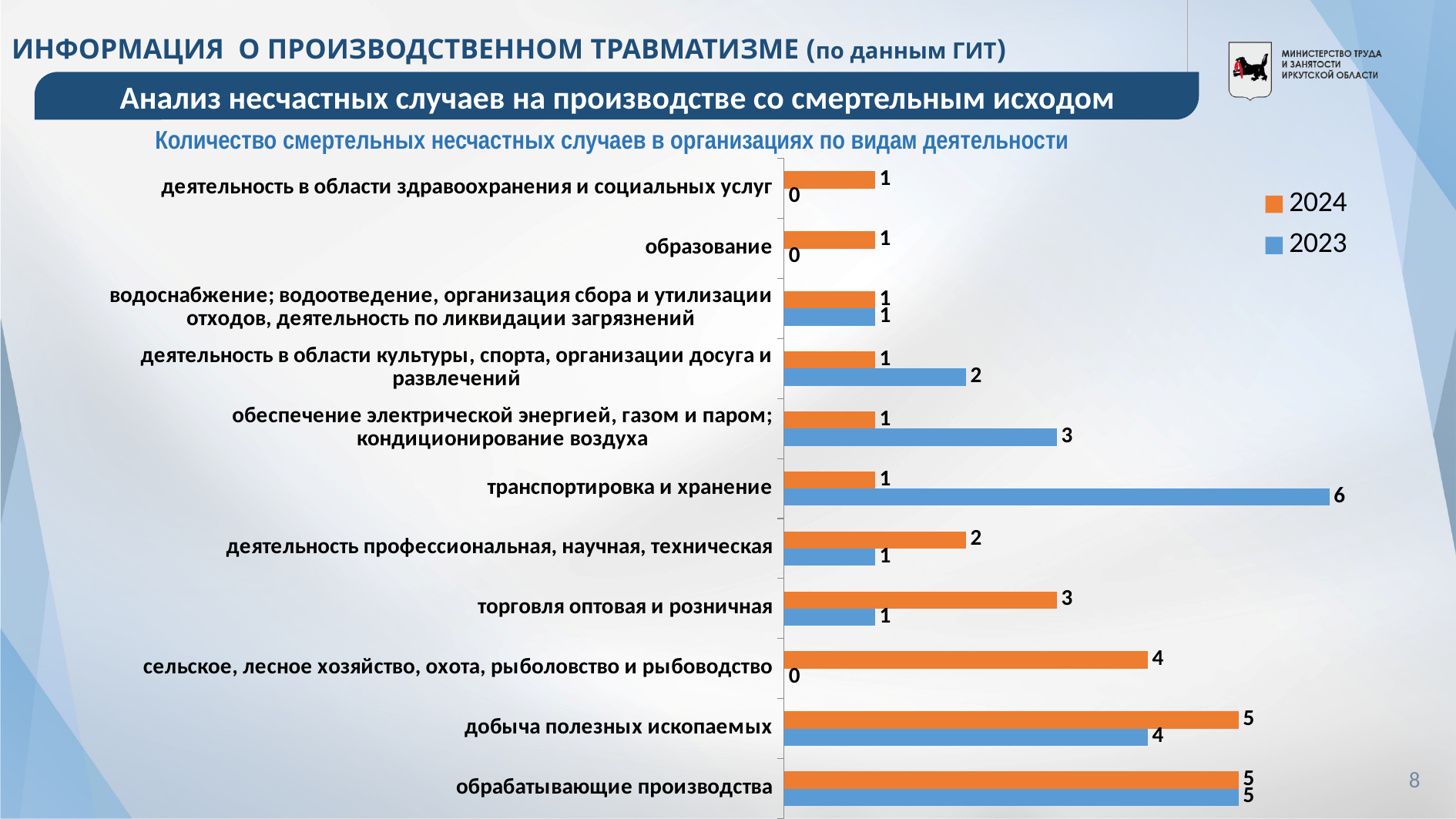
What is the 2023 value for «транспортировка и хранение»? 6 Which category has the highest 2023 value? транспортировка и хранение Which colour represents the 2024 series in the chart? orange Which is larger for «торговля оптовая и розничная»: the 2024 value or the 2023 value? 2024 What is the difference between the 2024 and 2023 values for «добыча полезных ископаемых»? 1 How many categories (types of activity) are shown in the chart? 11 How many series does the chart legend list? 2 What type of chart is shown on the slide? bar chart What is the 2023 value for «образование»? 0 What is the 2024 value for «сельское, лесное хозяйство, охота, рыболовство и рыбоводство»? 4 What is the 2024 value for «добыча полезных ископаемых»? 5 What is the difference between the 2023 and 2024 values for «транспортировка и хранение»? 5